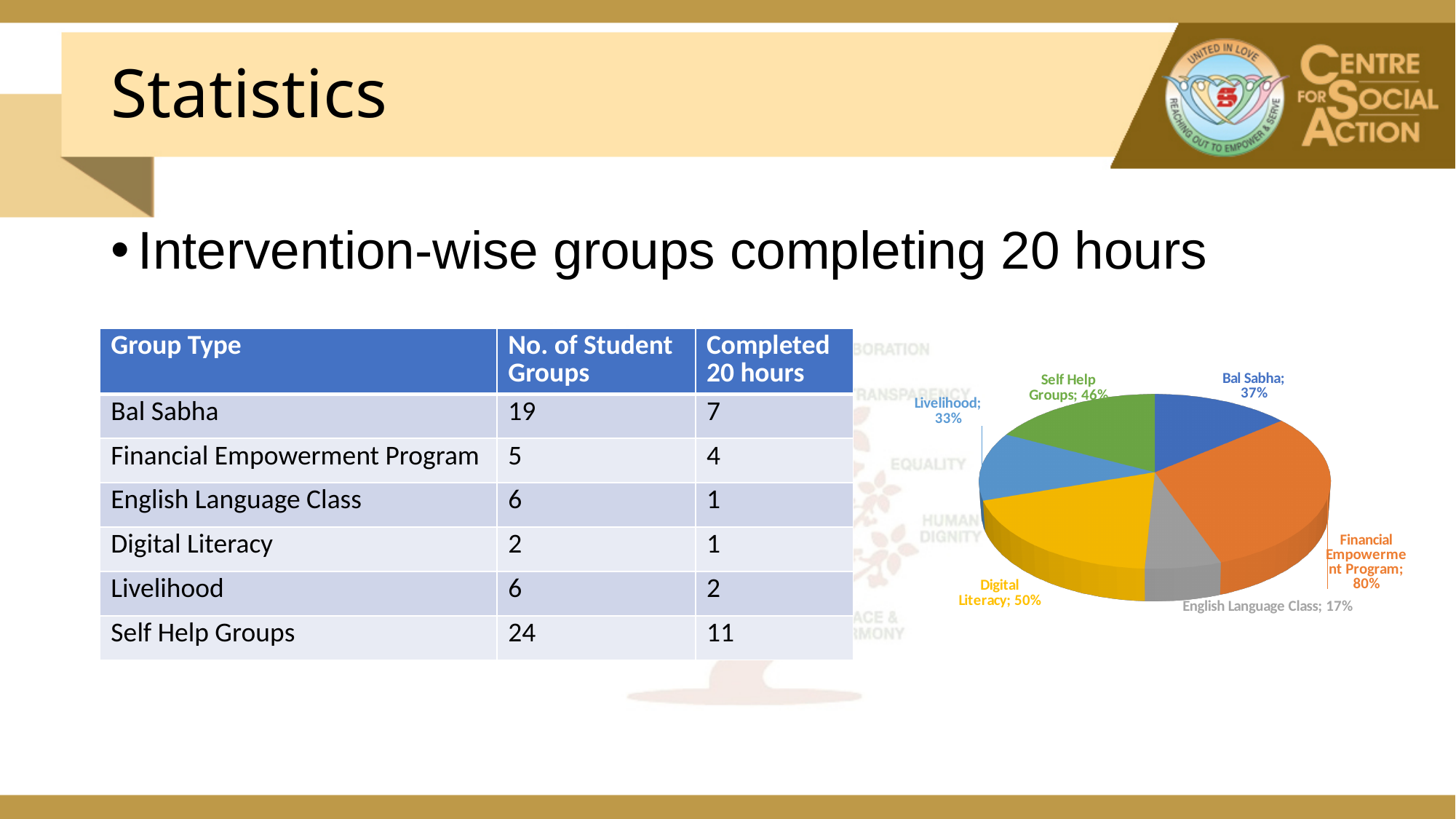
What kind of chart is shown on the slide? pie chart What value is labelled for English Language Class in the pie chart? 17% What value is labelled for Financial Empowerment Program in the pie chart? 80% Which category has the lowest labelled value in the pie chart? English Language Class What value is labelled for Digital Literacy in the pie chart? 50% What value is labelled for Bal Sabha in the pie chart? 37% Which has the larger labelled value in the pie chart, Digital Literacy or Self Help Groups? Digital Literacy What value is labelled for Self Help Groups in the pie chart? 46% How many slices does the pie chart have? 6 Which category has the highest labelled value in the pie chart? Financial Empowerment Program What value is labelled for Livelihood in the pie chart? 33% What is the difference between the labelled values for Financial Empowerment Program and English Language Class in the pie chart? 63 percentage points